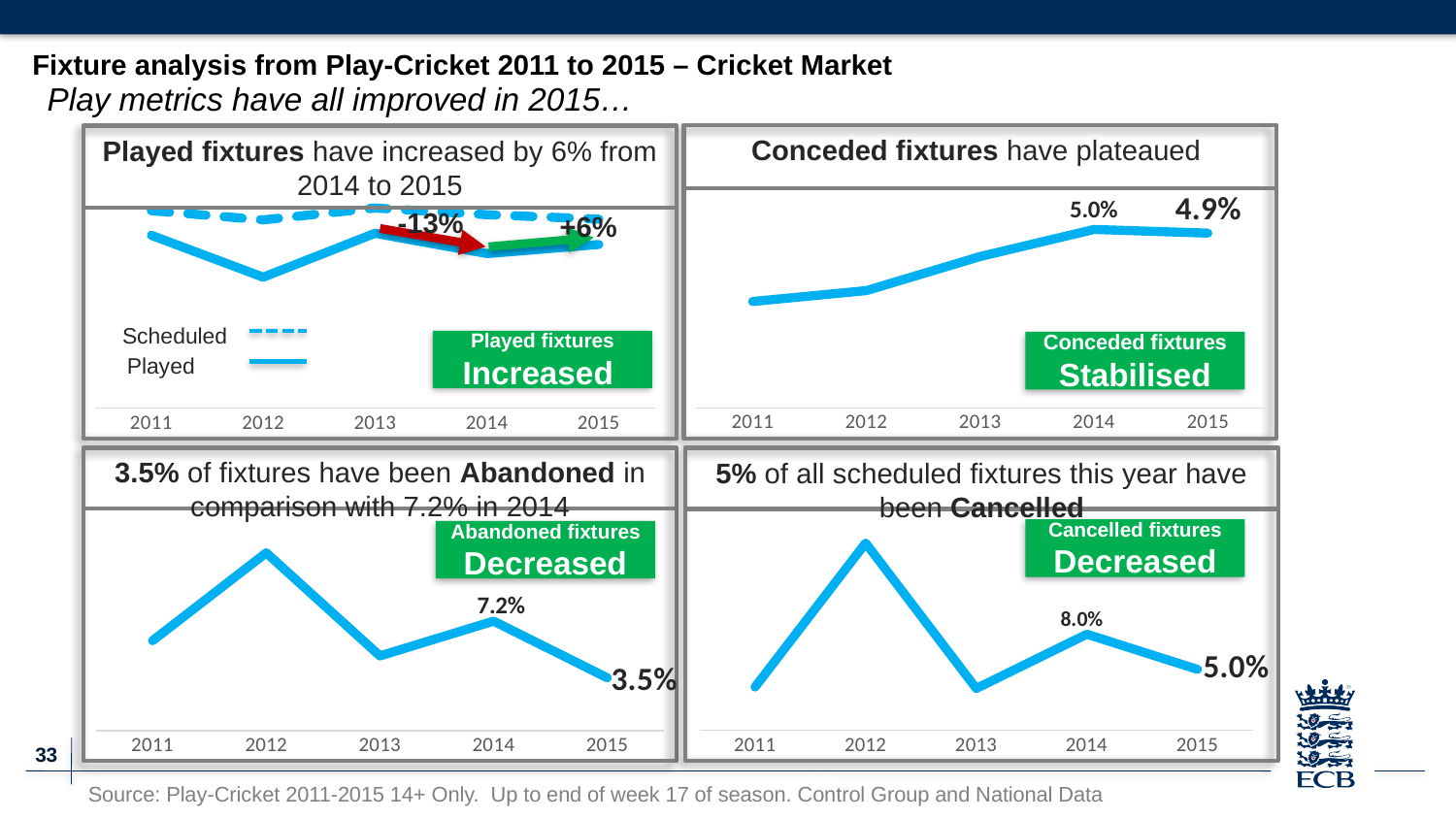
In the Abandoned fixtures chart (bottom left), which year has the highest value? 2012 How many years are shown on the x axis of the Cancelled fixtures chart (bottom right)? 5 In the Conceded fixtures chart (top right), what is the value for 2015? 4.9% In the Cancelled fixtures chart (bottom right), what is the value for 2014? 8.0% In the Cancelled fixtures chart (bottom right), what is the value for 2015? 5.0% In the Abandoned fixtures chart (bottom left), what is the value for 2014? 7.2% In the Cancelled fixtures chart (bottom right), which year has the highest value? 2012 In the Abandoned fixtures chart (bottom left), what is the value for 2015? 3.5% How many series does the legend of the Played fixtures chart (top left) list? 2 What type of chart is used in the Conceded fixtures panel (top right)? Line chart In the Abandoned fixtures chart (bottom left), by how many percentage points did the value fall from 2014 to 2015? 3.7 percentage points In the Conceded fixtures chart (top right), what is the value for 2014? 5.0%